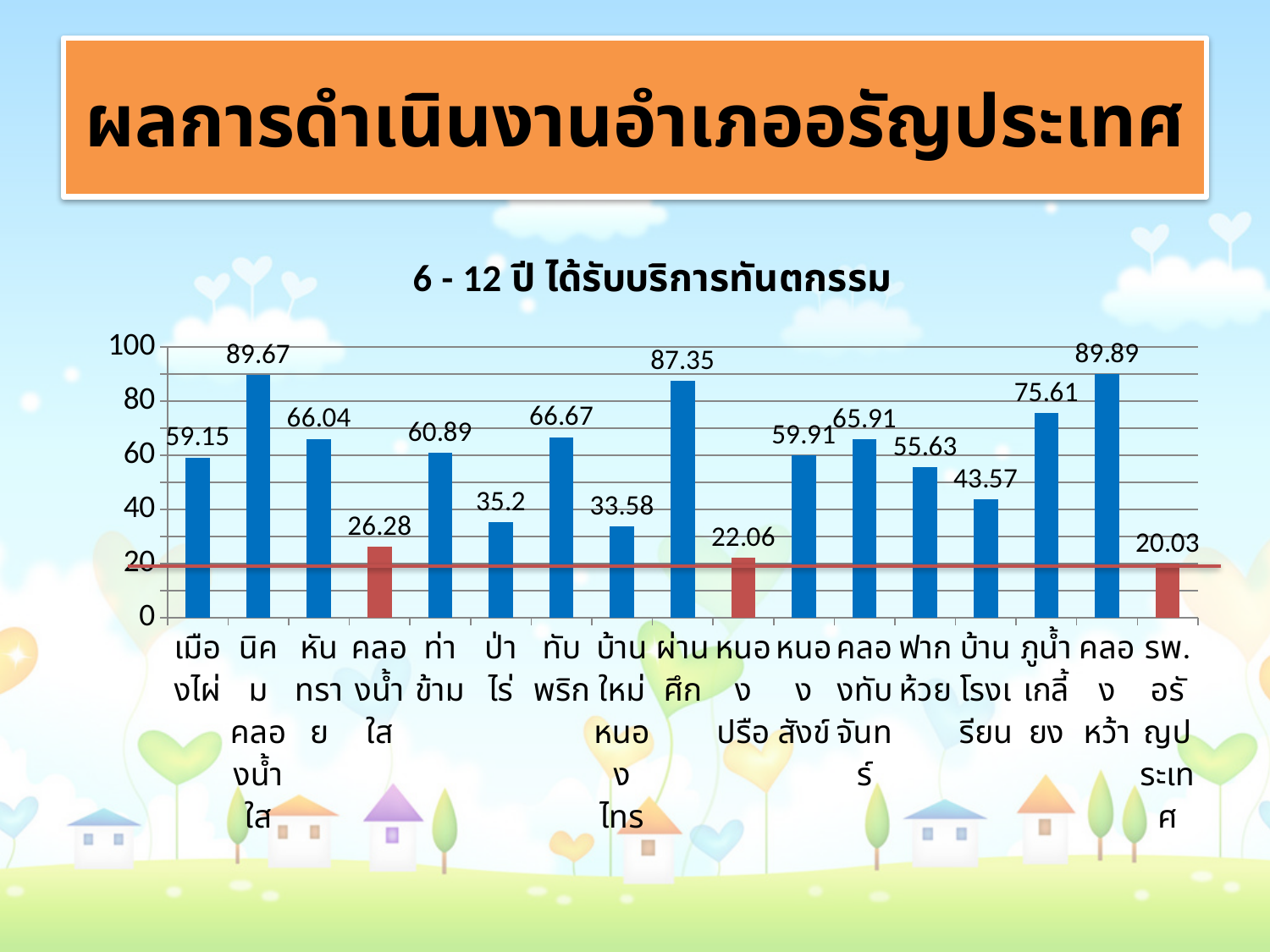
At what value on the y axis is the red horizontal line drawn? 20 What is the title of the chart? 6 - 12 ปี ได้รับบริการทันตกรรม What kind of chart is shown on the slide? bar chart What is the value for รพ.อรัญประเทศ? 20.03 What is the difference between the values for นิคมคลองน้ำใส and คลองน้ำใส? 63.39 Is the value for หนองปรือ greater or less than 40? less Which category has the highest value? คลองหว้า Which category has the lowest value? รพ.อรัญประเทศ What is the value for ผ่านศึก? 87.35 Which is larger, the value for ภูน้ำเกลี้ยง or the value for ฟากห้วย? ภูน้ำเกลี้ยง What is the value for เมืองไผ่ in the chart? 59.15 How many categories are shown on the x axis? 17